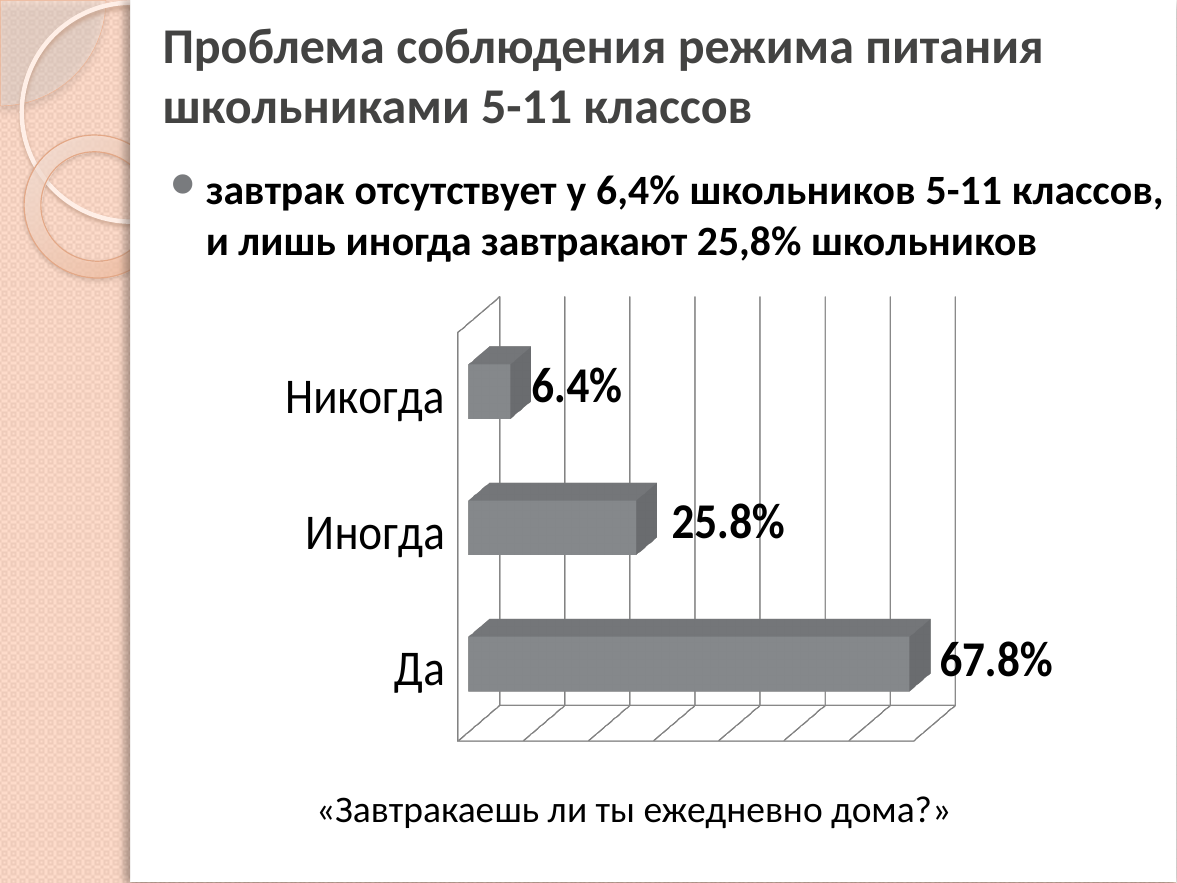
What is the value for «Иногда» in the chart? 25.8% Which is larger, the value for «Иногда» or the value for «Никогда»? Иногда What kind of chart is shown on the slide? Bar chart What question is written below the chart as its caption? «Завтракаешь ли ты ежедневно дома?» What is the value for «Да» in the chart? 67.8% Which category has the highest value in the chart? Да What is the total of the three values shown in the chart? 100.0% What is the difference between the values for «Да» and «Иногда»? 42.0% Which category has the lowest value in the chart? Никогда How many categories are shown in the chart? 3 What is the value for «Никогда» in the chart? 6.4% What is the difference between the values for «Иногда» and «Никогда»? 19.4%